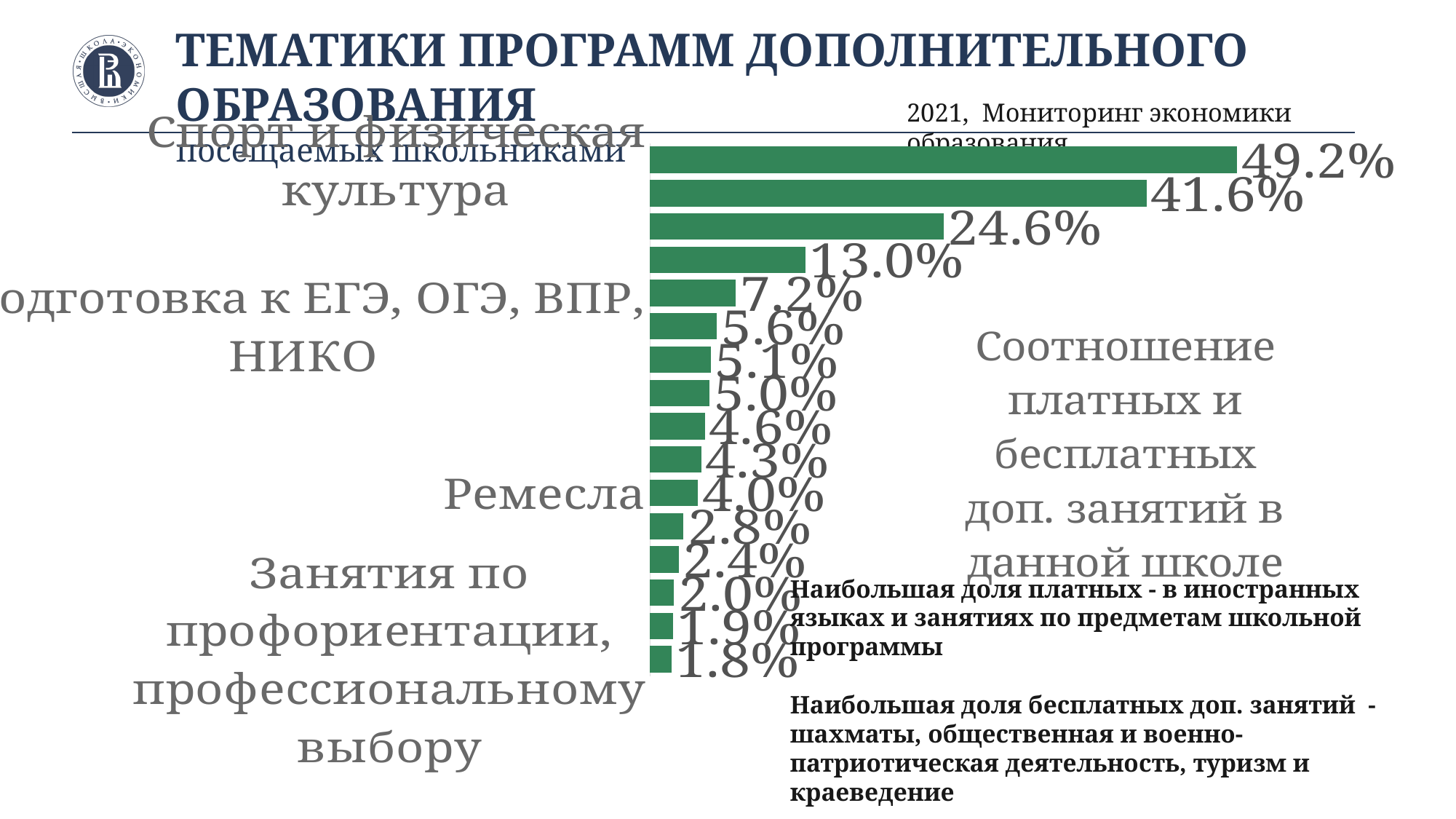
What is the value for the category 'Ремесла'? 4.0% What colour are the bars in the chart? green How many bars does the chart contain? 16 What is the difference between the two largest values in the chart (49.2% and 41.6%)? 7.6% What is the difference between the third bar (24.6%) and the fourth bar (13.0%)? 11.6% What is the lowest value shown in the chart? 1.8% What is the highest value shown in the chart? 49.2% What kind of chart is shown on the slide? bar chart What is the value of the second-longest bar in the chart? 41.6% Which is larger: the bar labelled 7.2% or the bar labelled 5.6%? 7.2% Do the bar values increase or decrease from the top of the chart to the bottom? decrease What is the value of the bar directly below the 2.8% bar? 2.4%